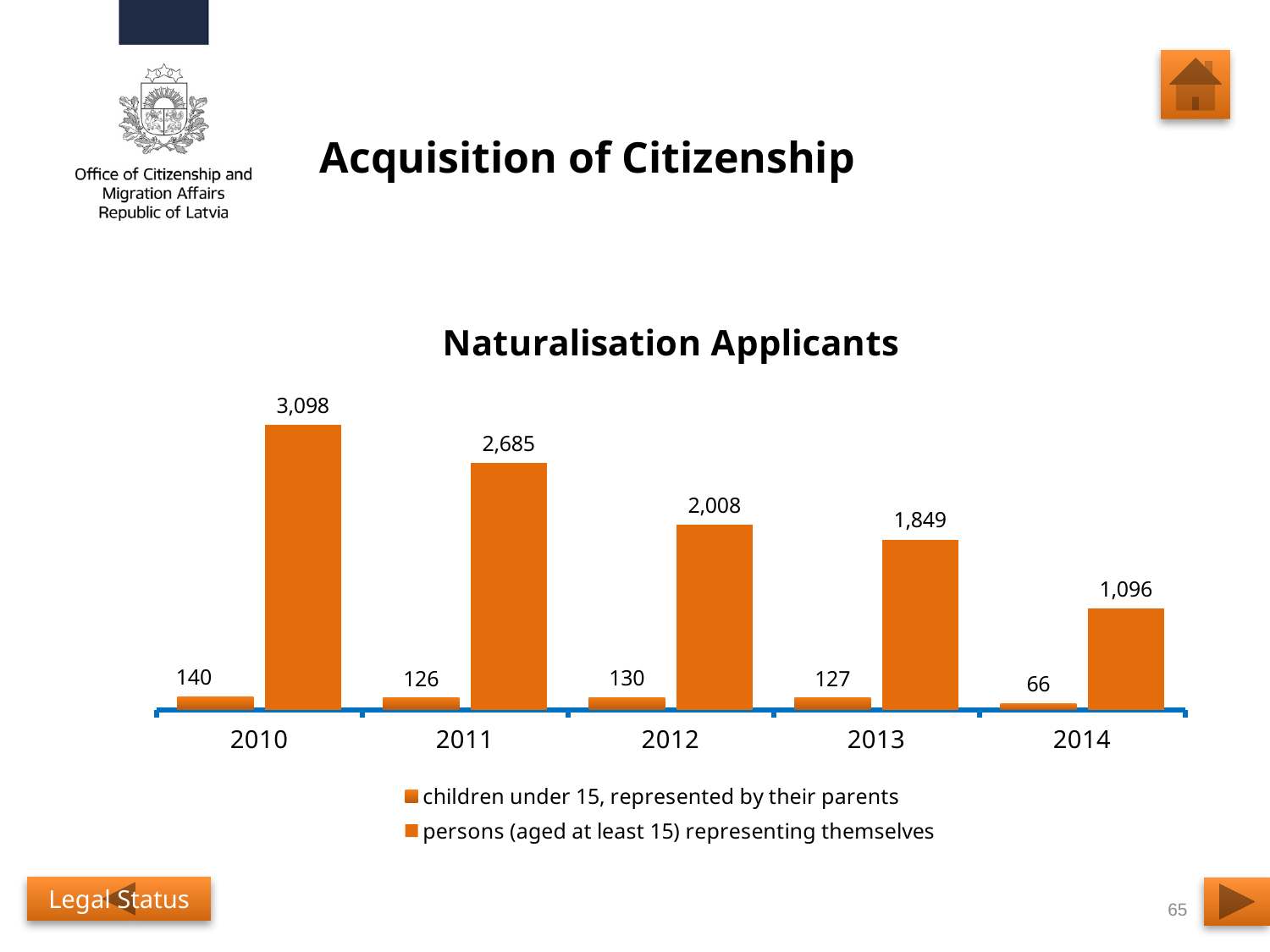
What is the difference between the values for persons (aged at least 15) representing themselves in 2011 and 2012? 677 Which year has the highest value for persons (aged at least 15) representing themselves? 2010 How many series does the legend list? 2 What is the value for persons (aged at least 15) representing themselves in 2010? 3,098 How many years are shown on the x axis? 5 Which is larger: the value for children under 15 in 2010 or in 2012? 2010 Do the values for persons (aged at least 15) representing themselves rise or fall from 2010 to 2014? fall What is the value for children under 15, represented by their parents in 2014? 66 What is the value for persons (aged at least 15) representing themselves in 2013? 1,849 What is the title of the chart? Naturalisation Applicants Which year has the lowest value for children under 15, represented by their parents? 2014 What kind of chart is shown on the slide? bar chart